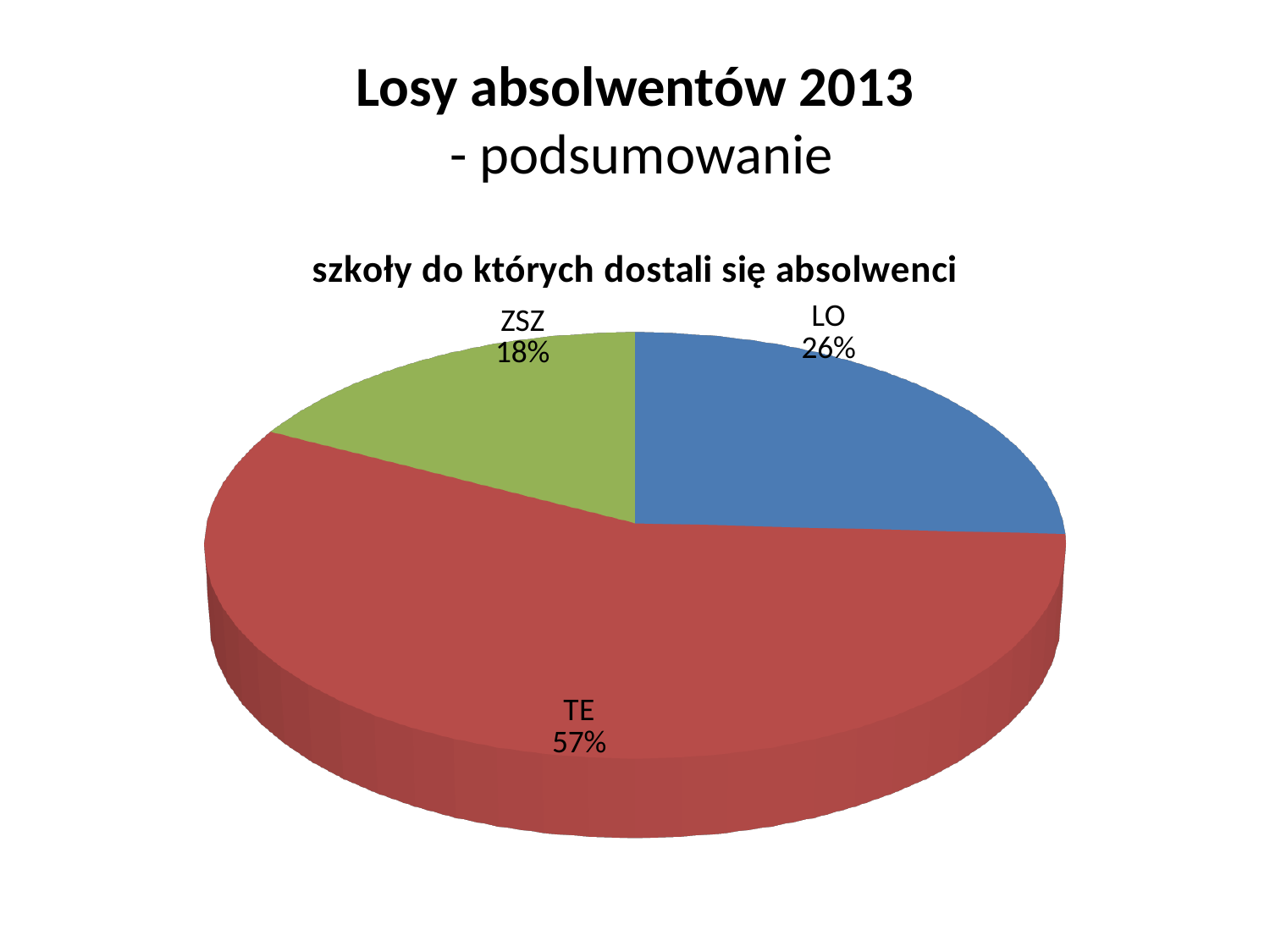
Which is larger, the share for LO or the share for ZSZ? LO What share of the pie does TE account for? 57% Which category has the largest slice of the pie? TE What is the title of the chart? szkoły do których dostali się absolwenci What kind of chart is shown on the slide? Pie chart What is the difference in percentage points between LO and ZSZ? 8 How many categories are shown in the pie chart? 3 Which category has the smallest slice of the pie? ZSZ What share of the pie does LO account for? 26% What colour is the TE slice? Red What is the difference in percentage points between TE and LO? 31 What share of the pie does ZSZ account for? 18%